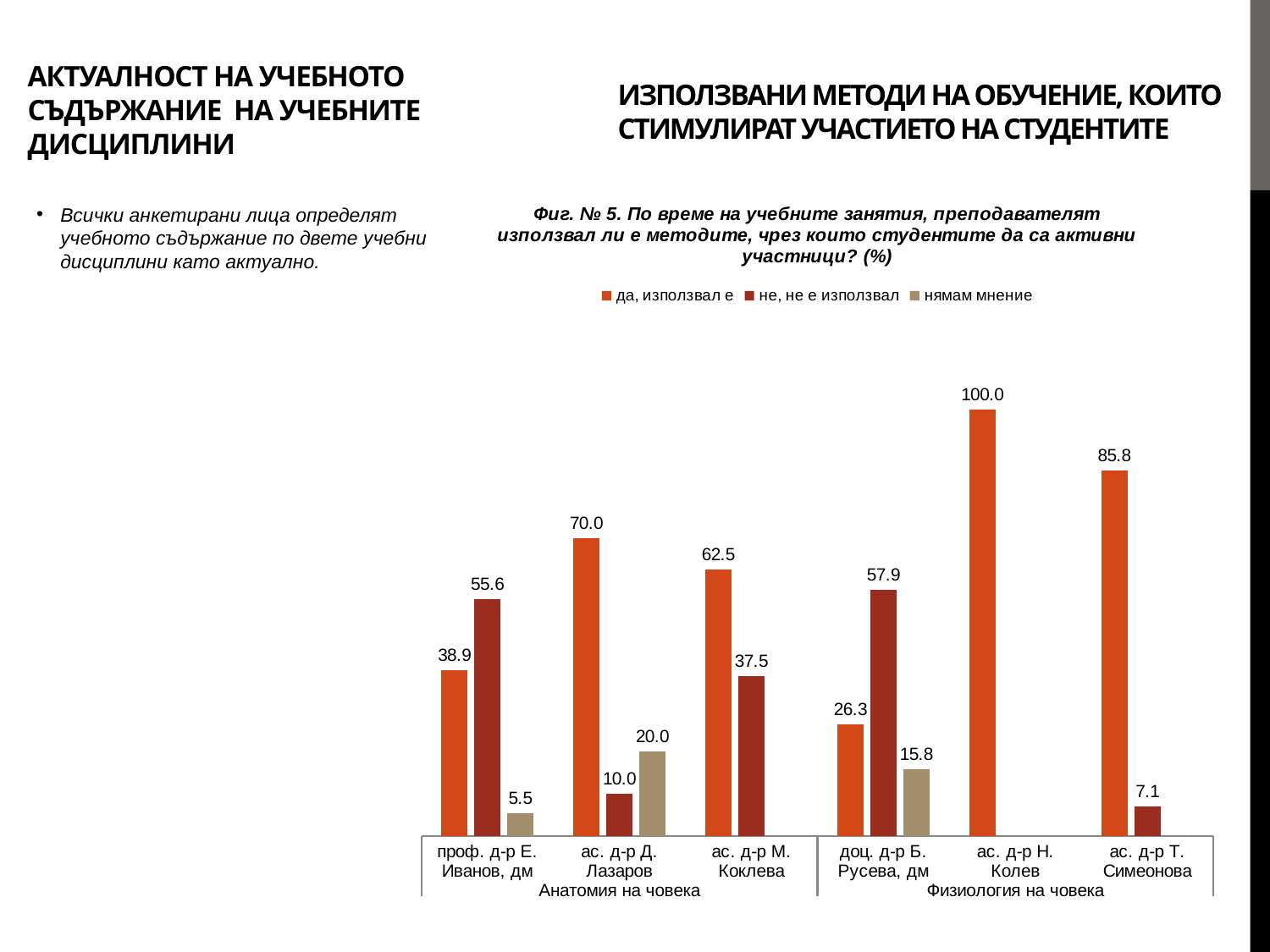
What is the value of "не, не е използвал" for доц. д-р Б. Русева, дм? 57.9 What type of chart is shown on the slide? bar chart What is the difference between the "да, използвал е" and "не, не е използвал" values for ас. д-р Т. Симеонова? 78.7 What is the value of "нямам мнение" for ас. д-р Д. Лазаров? 20.0 Which two disciplines are the lecturers grouped under on the x axis? Анатомия на човека and Физиология на човека Which lecturer has the highest value for "да, използвал е"? ас. д-р Н. Колев For проф. д-р Е. Иванов, дм, which is larger: "да, използвал е" or "не, не е използвал"? не, не е използвал What is the value of "да, използвал е" for ас. д-р Н. Колев? 100.0 What is the value of "не, не е използвал" for ас. д-р М. Коклева? 37.5 How many series does the chart legend list? 3 Which lecturer has the lowest value for "да, използвал е"? доц. д-р Б. Русева, дм How many lecturers (categories) are shown on the x axis of the chart? 6